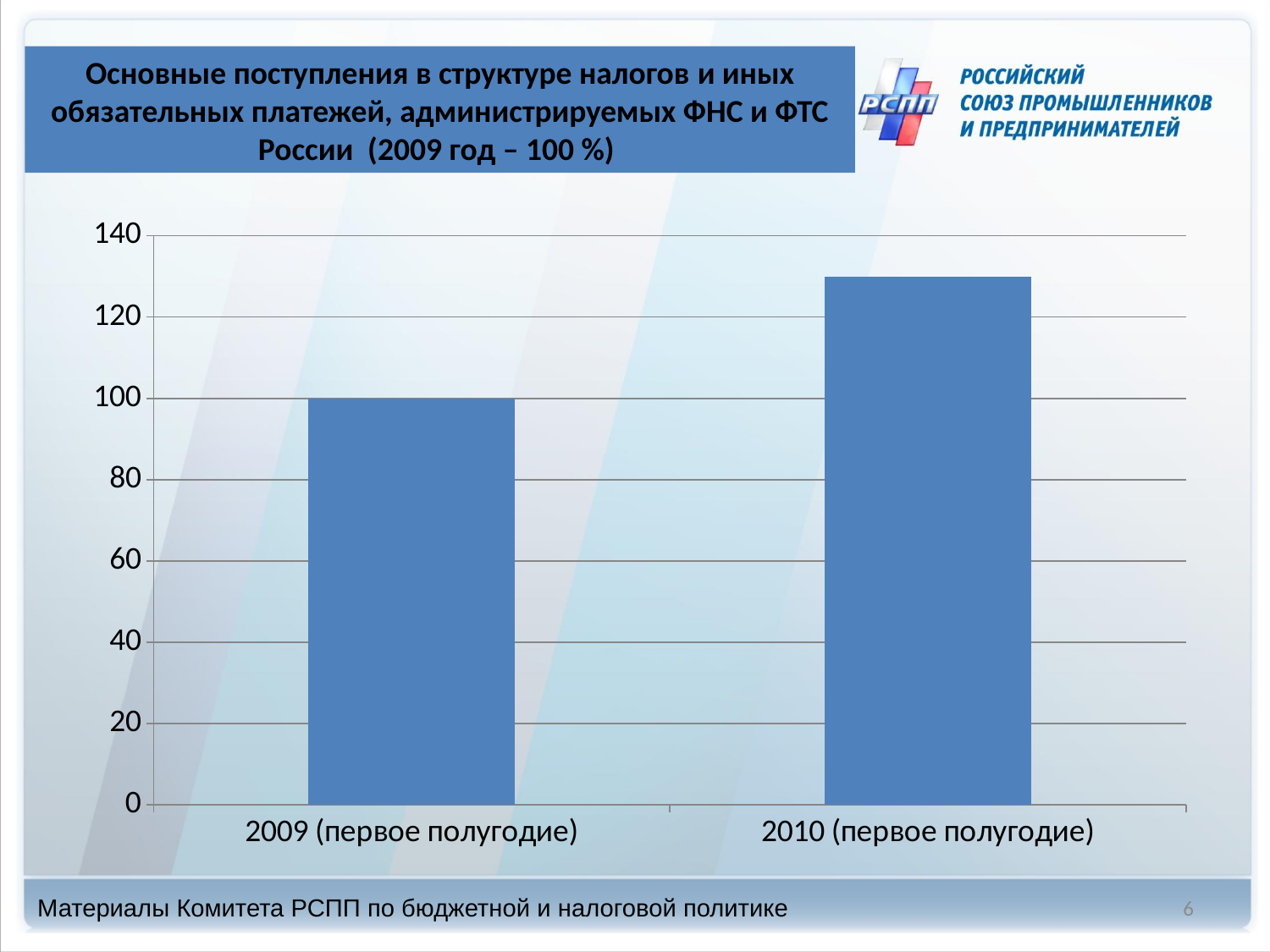
Is the value for 2010 (первое полугодие) greater or less than 120? greater What kind of chart is shown on the slide? bar chart Which category has the lowest bar in the chart? 2009 (первое полугодие) How many categories are plotted on the x axis of the chart? 2 What is the highest tick value shown on the vertical axis of the chart? 140 Which is larger, the bar for 2009 (первое полугодие) or the bar for 2010 (первое полугодие)? 2010 (первое полугодие) What is the value of the bar for 2009 (первое полугодие)? 100 Is the value for 2010 (первое полугодие) greater or less than 140? less Is the value for 2009 (первое полугодие) greater or less than 80? greater Which category has the highest bar in the chart? 2010 (первое полугодие) Do the values rise or fall from 2009 (первое полугодие) to 2010 (первое полугодие)? rise According to the slide title, which year is taken as 100 %? 2009